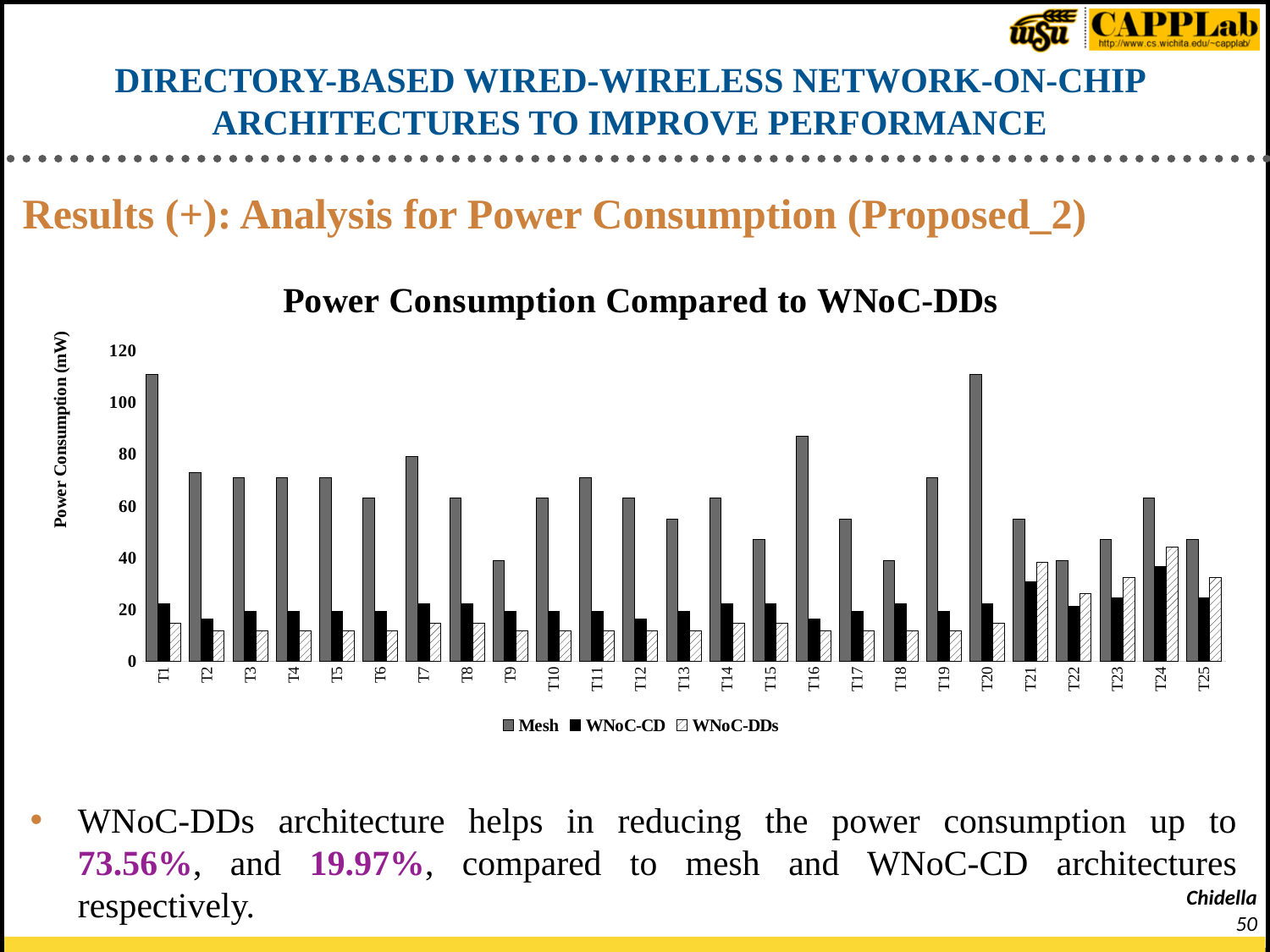
What is the title of the chart? Power Consumption Compared to WNoC-DDs Which category has the highest WNoC-CD value? T24 What is the label of the vertical axis? Power Consumption (mW) How many series does the legend list? 3 How many categories (T1 to T25) are plotted on the x axis? 25 Which category has the highest WNoC-DDs value? T24 Is the Mesh value for T9 greater or less than 60? less Is the Mesh value for T1 greater or less than 100? greater Is the Mesh value for T16 greater or less than 80? greater What kind of chart is shown on the slide? bar chart For T24, which is larger: the WNoC-CD value or the WNoC-DDs value? WNoC-DDs